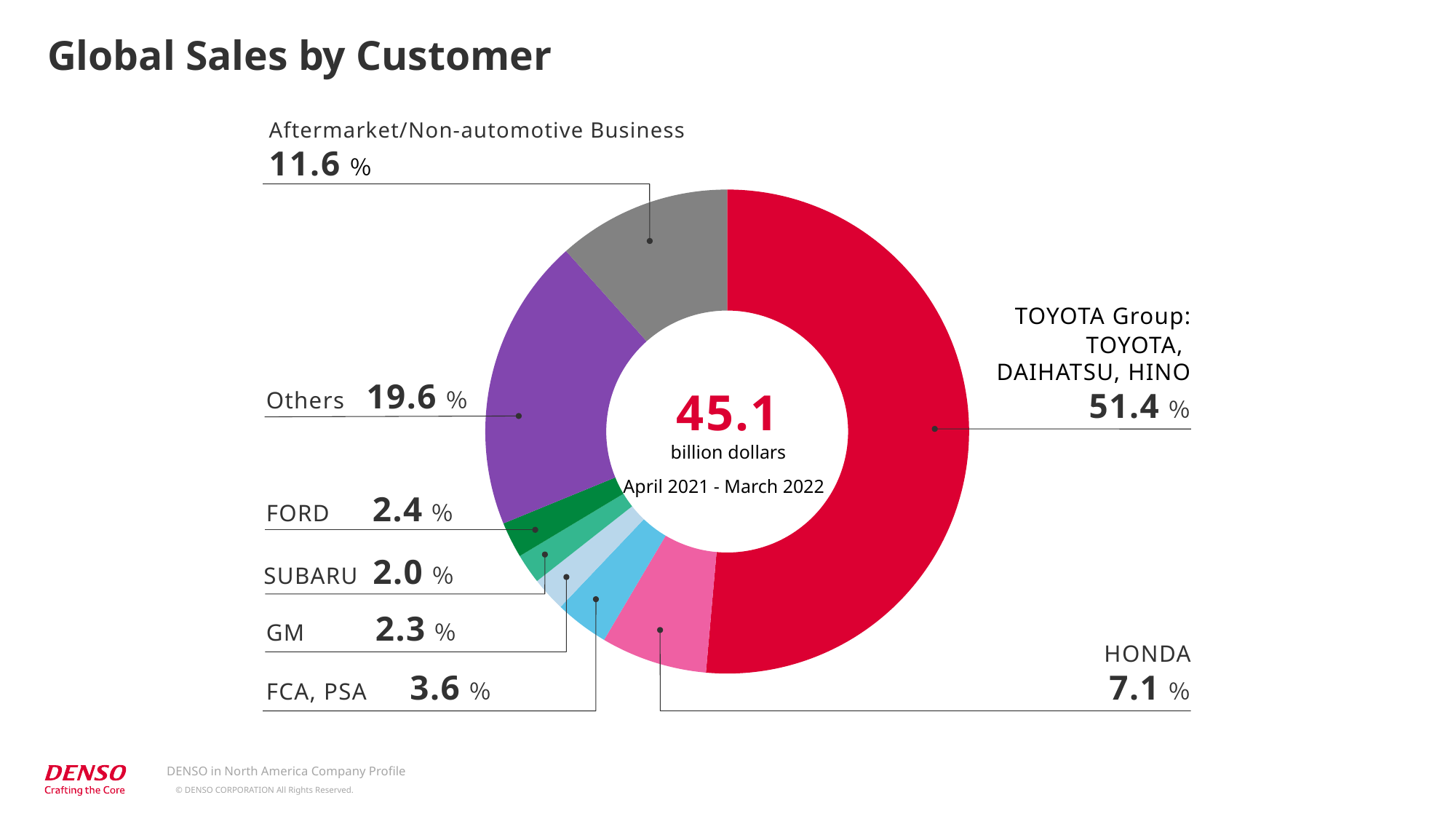
What percentage of global sales is attributed to HONDA? 7.1 % What percentage is shown for FCA, PSA? 3.6 % What kind of chart is used on this slide? Donut (pie) chart What share of global sales does the TOYOTA Group account for? 51.4 % How many customer categories are shown in the chart? 8 What is the difference in percentage points between Others and Aftermarket/Non-automotive Business? 8.0 % Which has a larger share, GM or FORD? FORD Which customer category has the smallest share of global sales? SUBARU Which customer category has the largest share of global sales? TOYOTA Group What total sales figure is shown in the center of the chart? 45.1 billion dollars What period does the chart cover? April 2021 - March 2022 What is the share for Aftermarket/Non-automotive Business? 11.6 %